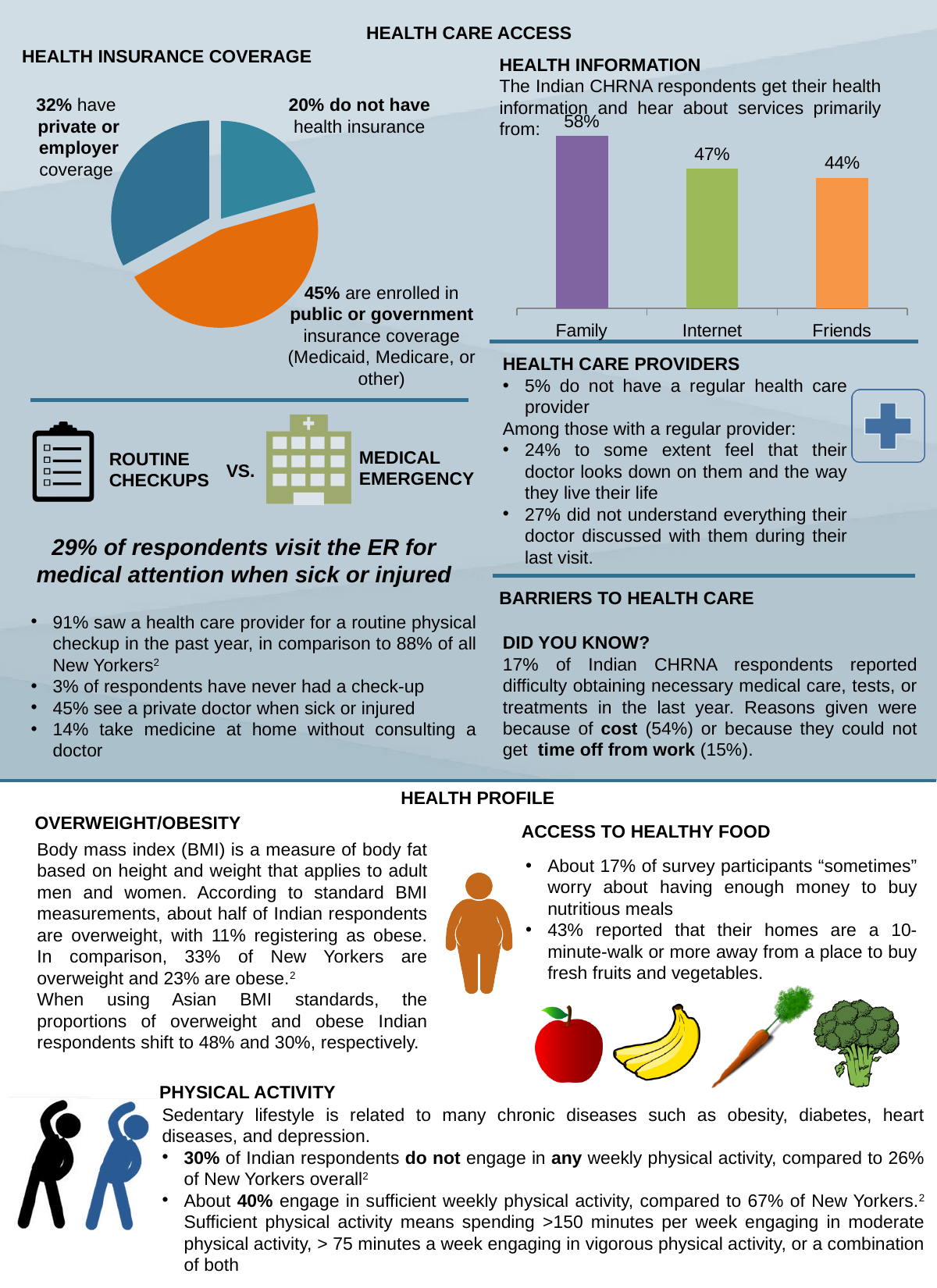
In the Health Information bar chart, which source has the highest value? Family In the Health Information bar chart, what percentage of respondents get their health information from Family? 58% In the Health Information bar chart, do the values rise or fall from Family to Friends? Fall In the Health Insurance Coverage pie chart, what percentage have private or employer coverage? 32% In the Health Insurance Coverage pie chart, what percentage do not have health insurance? 20% In the Health Information bar chart, what is the value for Internet? 47% In the Health Information bar chart, what is the difference between the values for Family and Friends? 14% What kind of chart is used in the Health Information section? Bar chart In the Health Insurance Coverage pie chart, which is larger: private or employer coverage, or no health insurance? Private or employer coverage In the Health Information bar chart, how many sources are shown? 3 In the Health Insurance Coverage pie chart, which category has the largest share? Public or government insurance coverage In the Health Information bar chart, which source has the lowest value? Friends